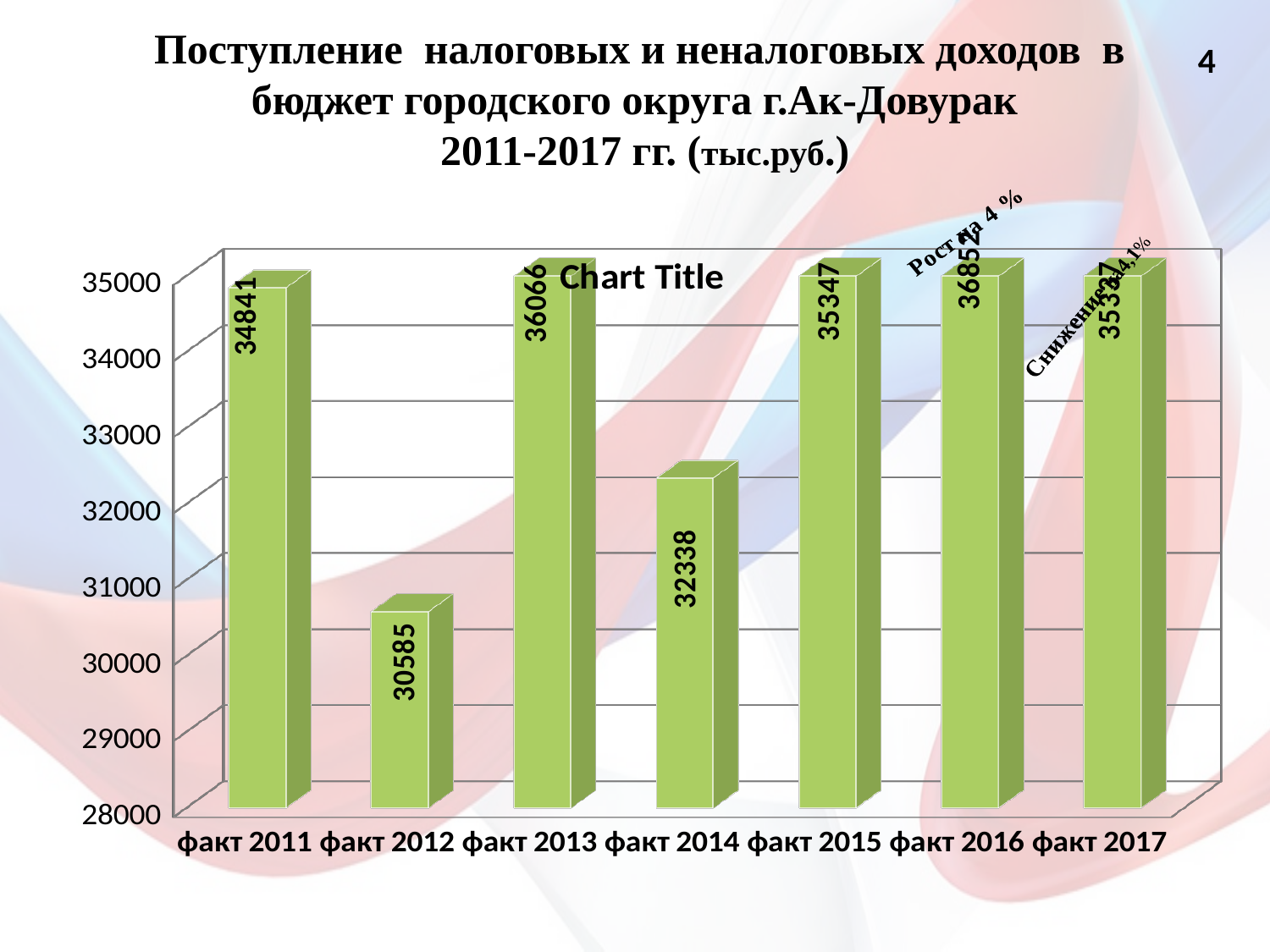
Is the value for факт 2017 greater or less than 34000? greater What is the value for факт 2011? 34841 What kind of chart is shown on the slide? bar chart What is the value for факт 2012? 30585 Is the value for факт 2016 greater or less than 35000? greater What is the value for факт 2015? 35347 How many categories are shown on the x axis? 7 What is the difference between the values for факт 2013 and факт 2012? 5481 What is the value for факт 2013? 36066 Which category has the lowest value? факт 2012 Which is larger, the value for факт 2011 or факт 2014? факт 2011 What is the value for факт 2014? 32338